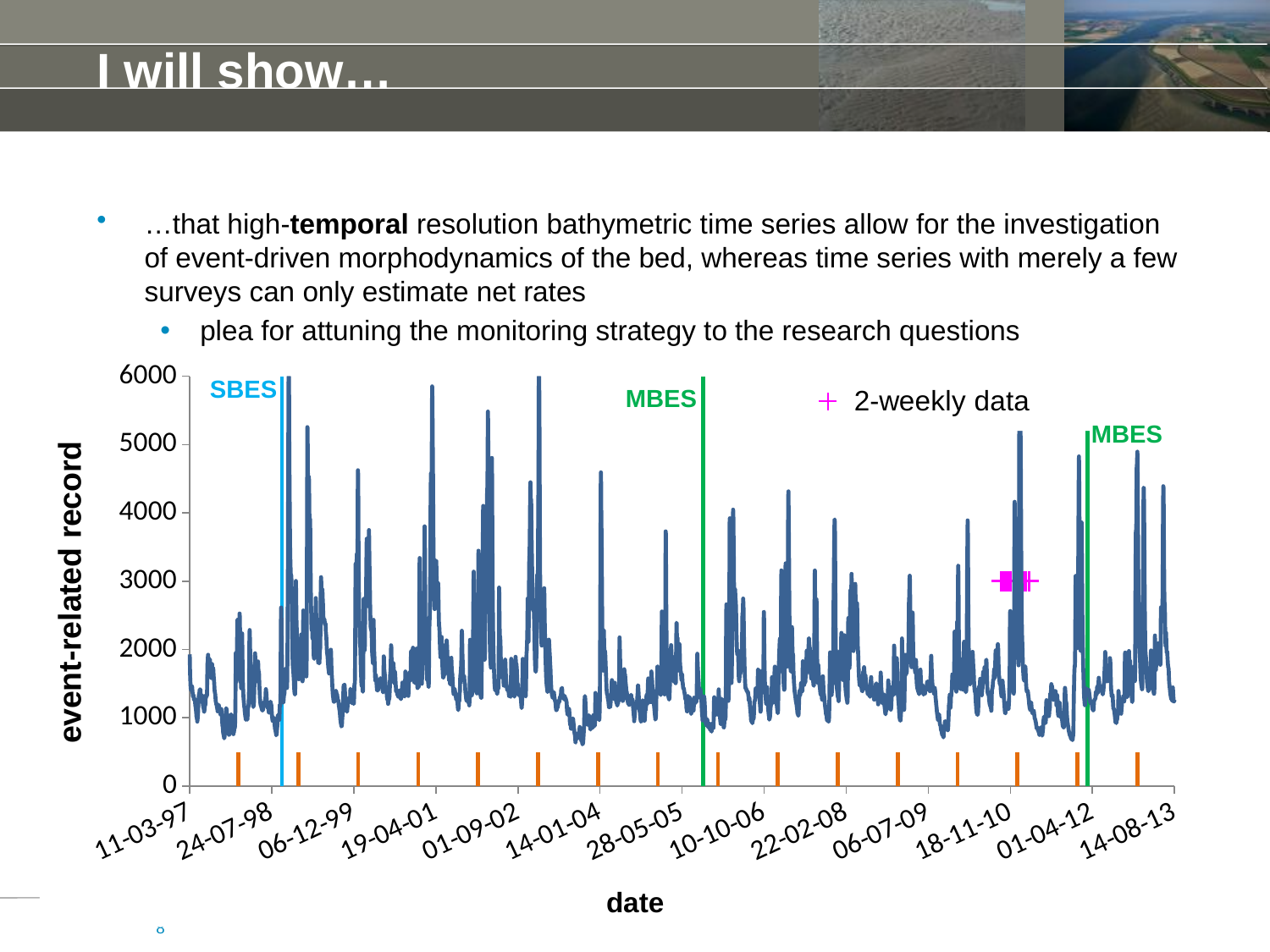
Is the lowest value of the event-related record series greater or less than 1000? less What is the title of the x axis of the chart? date Is the highest peak of the event-related record series greater or less than 5000? greater What is the last date label on the x axis of the chart? 14-08-13 What kind of chart is shown on the slide? line chart What is the highest value shown on the y axis of the chart? 6000 How many date labels are shown along the x axis of the chart? 13 Is the value of the event-related record at the start of the series (11-03-97) greater or less than 3000? less How many entries does the chart's legend list? 1 What is the title of the y axis of the chart? event-related record What is the first date label on the x axis of the chart? 11-03-97